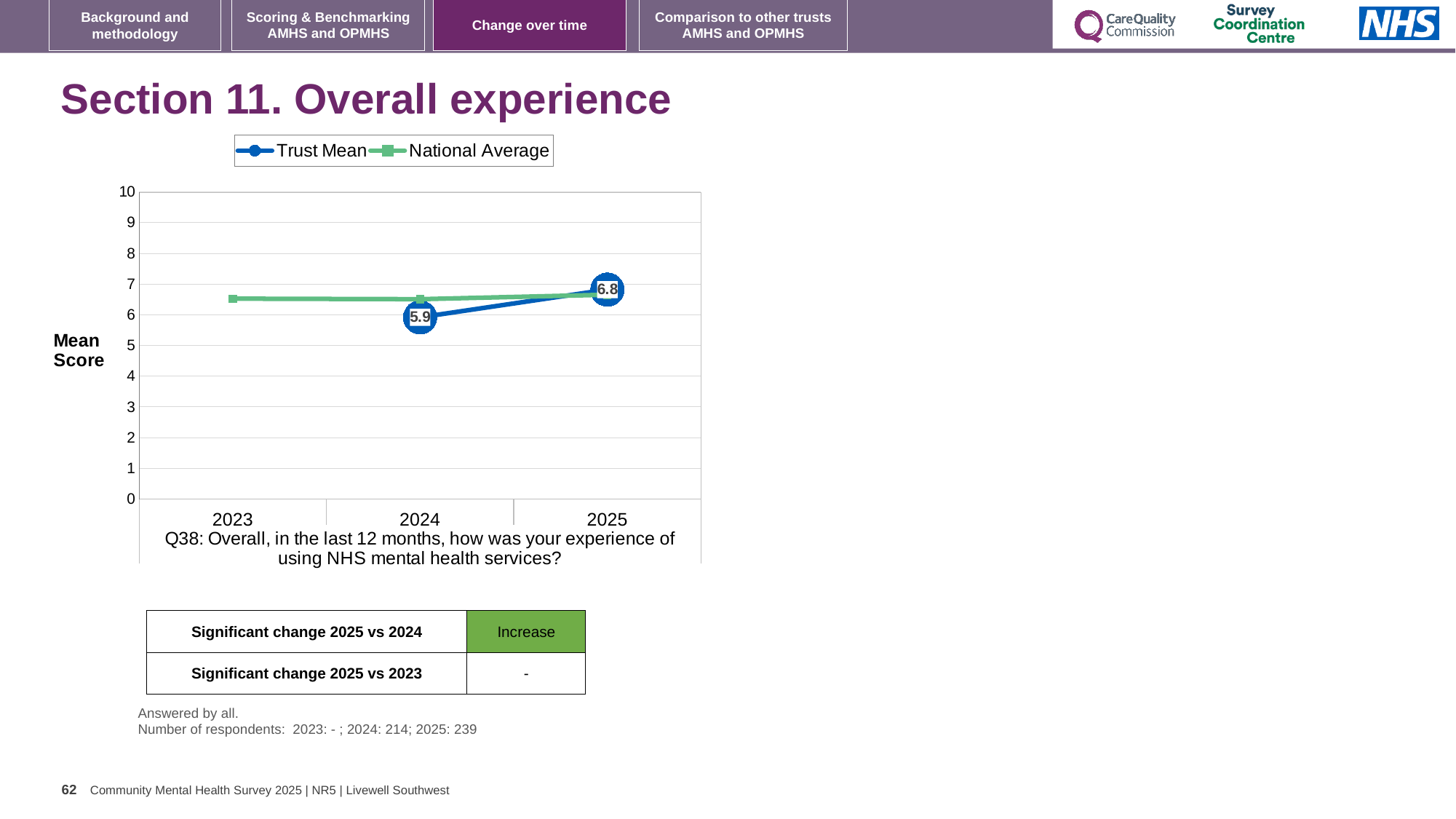
What kind of chart is shown on the slide? line chart In which year is the Trust Mean highest? 2025 How many years are shown on the x axis? 3 What is the Trust Mean value for 2024? 5.9 What is the Trust Mean value for 2025? 6.8 Does the Trust Mean rise or fall from 2024 to 2025? rise In 2024, which is larger: the Trust Mean or the National Average? National Average Is the National Average value for 2023 greater or less than 5? greater Is the Trust Mean value for 2024 greater or less than 7? less What is the difference between the Trust Mean in 2025 and the Trust Mean in 2024? 0.9 What is the label on the y axis of the chart? Mean Score How many series does the legend list? 2